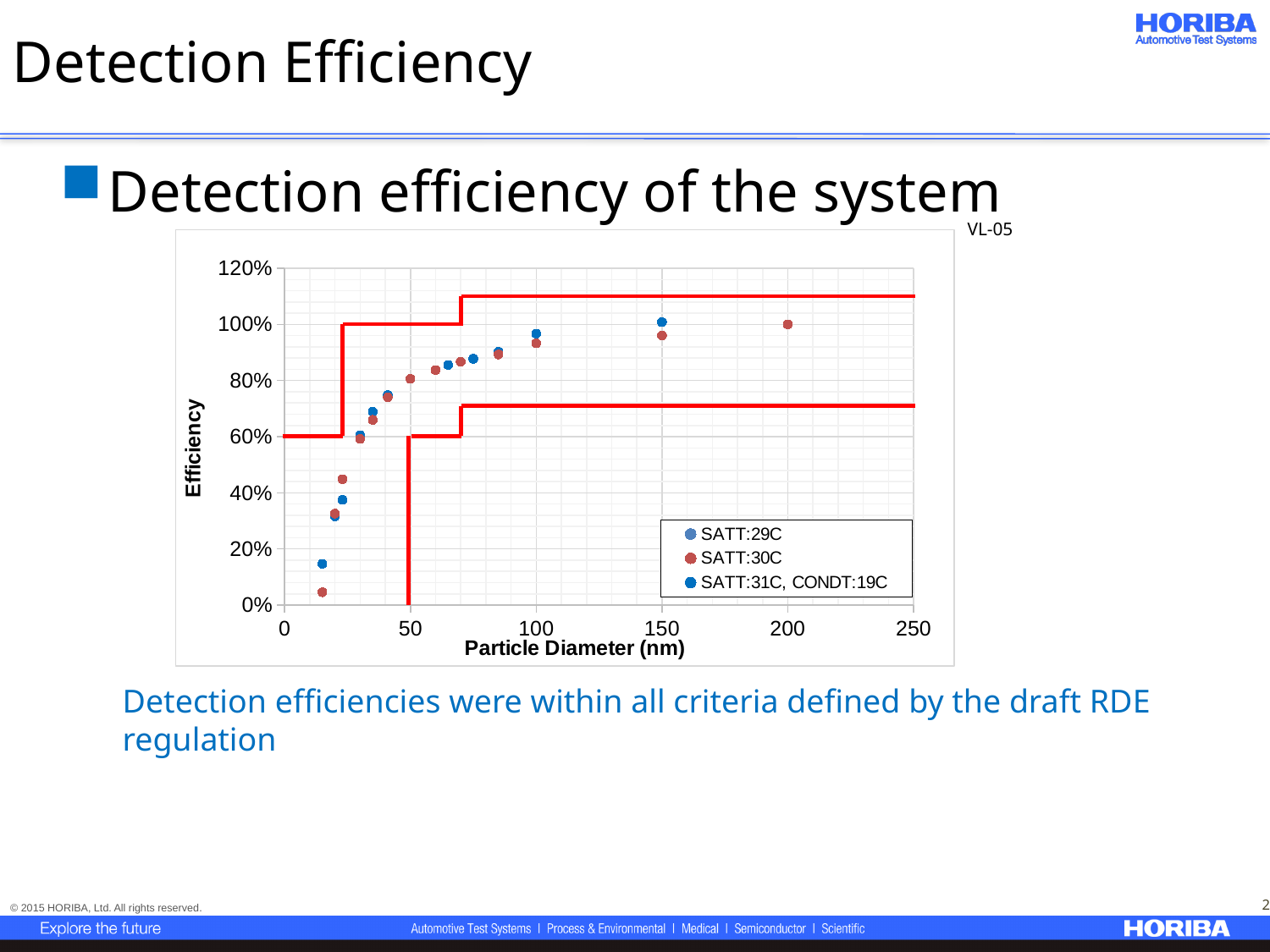
What is the highest value shown on the y axis of the chart? 120% Do the plotted efficiency values rise or fall as particle diameter increases along the x axis? rise What is the label of the x axis of the chart? Particle Diameter (nm) How many series does the chart legend list? 3 Is the SATT:30C efficiency value at the smallest plotted particle diameter (about 15 nm) greater or less than 20%? less Is the SATT:30C efficiency value at a particle diameter of 200 nm greater or less than 80%? greater Are the plotted efficiency values at a particle diameter of 100 nm greater or less than 80%? greater What is the label of the y axis of the chart? Efficiency What kind of chart is shown on the slide? scatter chart